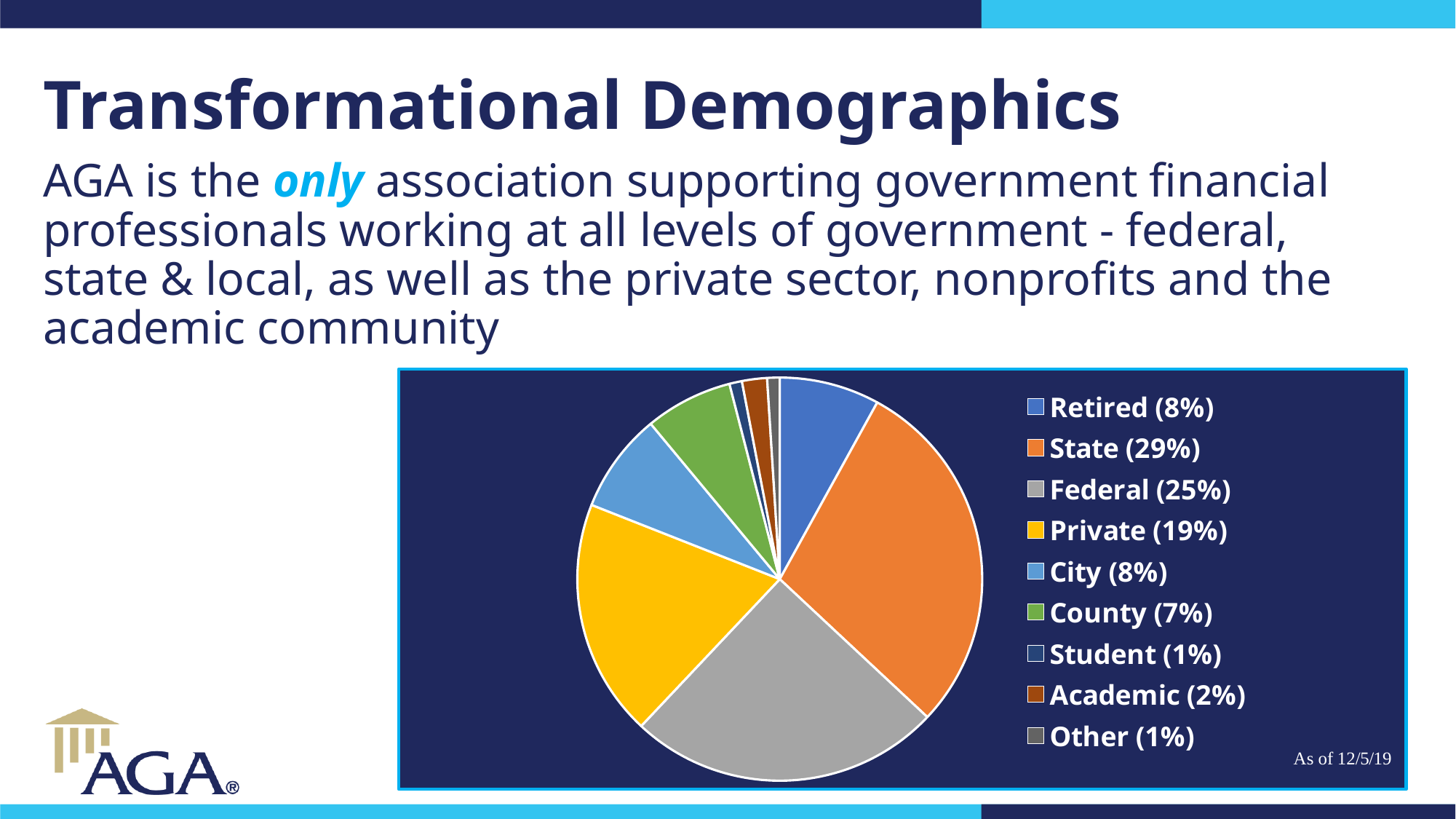
What share of the pie does State represent? 29% What share of the pie does Federal represent? 25% What is the difference in percentage points between Private and County? 12 What date is the chart data stated to be as of? 12/5/19 What percentage is shown for Private in the legend? 19% What kind of chart is shown on the slide? pie chart Which category has the largest share of the pie? State What colour is the State slice in the pie chart? orange What is the difference in percentage points between State and Federal? 4 What percentage is shown for County in the legend? 7% How many categories does the pie chart show? 9 Which is larger, the share for Private or the share for City? Private